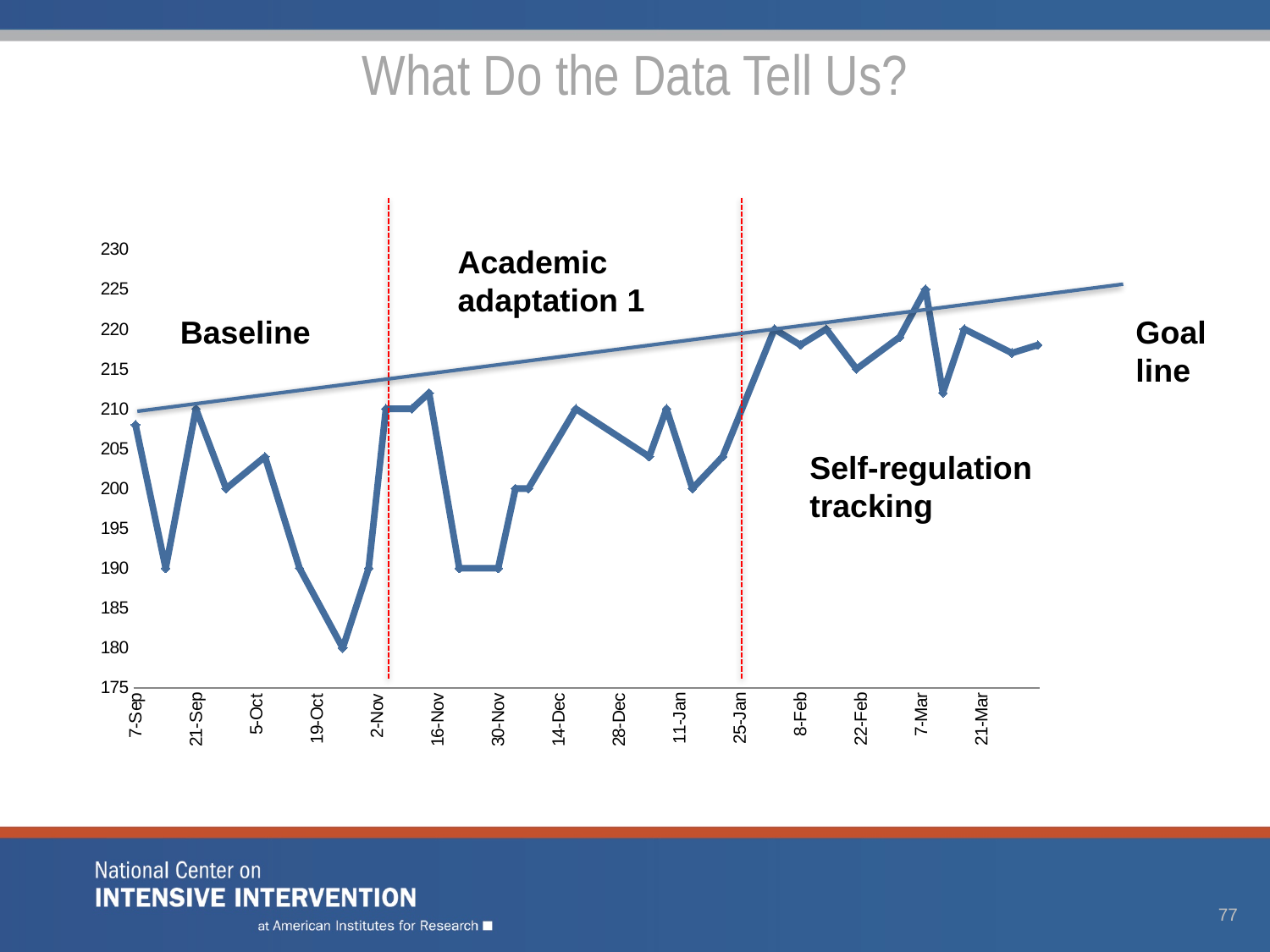
Is the value for 21-Mar greater or less than 210? greater Is the value for 8-Feb greater or less than 215? greater Is the value for 7-Mar greater or less than 220? greater What kind of chart is shown on the slide? line chart On which date does the plotted line reach its highest value? 7-Mar Does the goal line rise or fall from left to right? rise What are the three phases labelled on the chart? Baseline, Academic adaptation 1, Self-regulation tracking How many date labels are shown on the x axis? 15